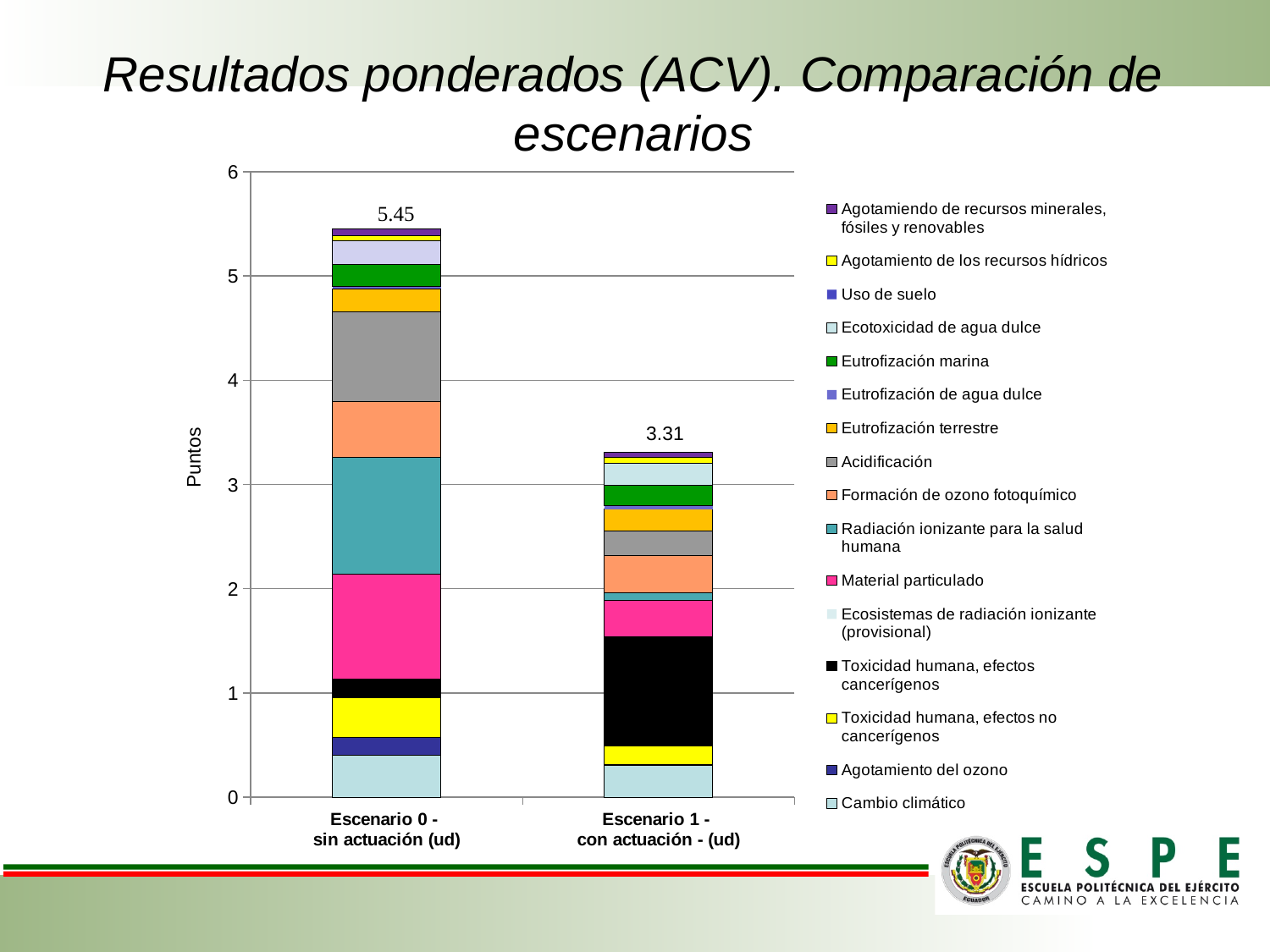
How many series does the legend list? 16 How many categories (scenarios) are plotted on the x axis? 2 What is the label of the y axis? Puntos What kind of chart is shown on the slide? Stacked bar chart Do the totals rise or fall from Escenario 0 to Escenario 1? Fall Is the total for Escenario 0 - sin actuación (ud) greater or less than 5? greater Which scenario has the higher total, Escenario 0 or Escenario 1? Escenario 0 - sin actuación (ud) Is the total for Escenario 1 - con actuación - (ud) greater or less than 4? less Which category has the lowest total? Escenario 1 - con actuación - (ud) What is the total value shown for Escenario 0 - sin actuación (ud)? 5.45 What is the difference between the totals of Escenario 0 and Escenario 1? 2.14 What is the total value shown for Escenario 1 - con actuación - (ud)? 3.31